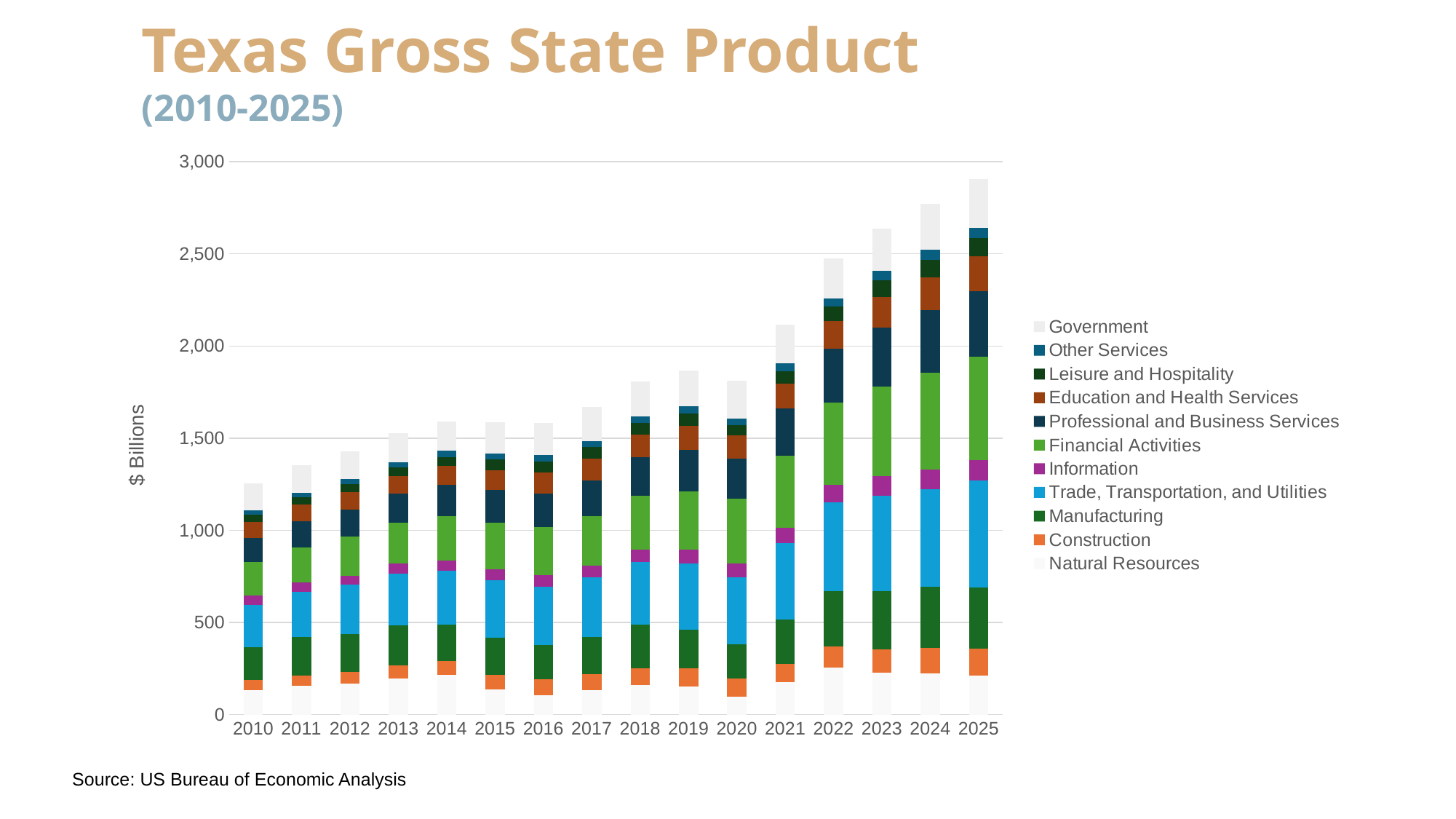
How many years (bars) are shown on the x axis of the chart? 16 Which year has the highest total Texas Gross State Product in the chart? 2025 Is the total value for 2022 greater or less than 2,000? greater Is the total value for 2010 greater or less than 1,500? less What kind of chart is shown on the slide? Stacked bar chart What is the label on the chart's y axis? $ Billions Is the total value for 2020 greater or less than 2,000? less Which year has the lowest total Texas Gross State Product in the chart? 2010 Do the total bar values generally rise or fall from 2010 to 2025? Rise Which year has a larger total, 2022 or 2023? 2023 How many series does the chart's legend list? 11